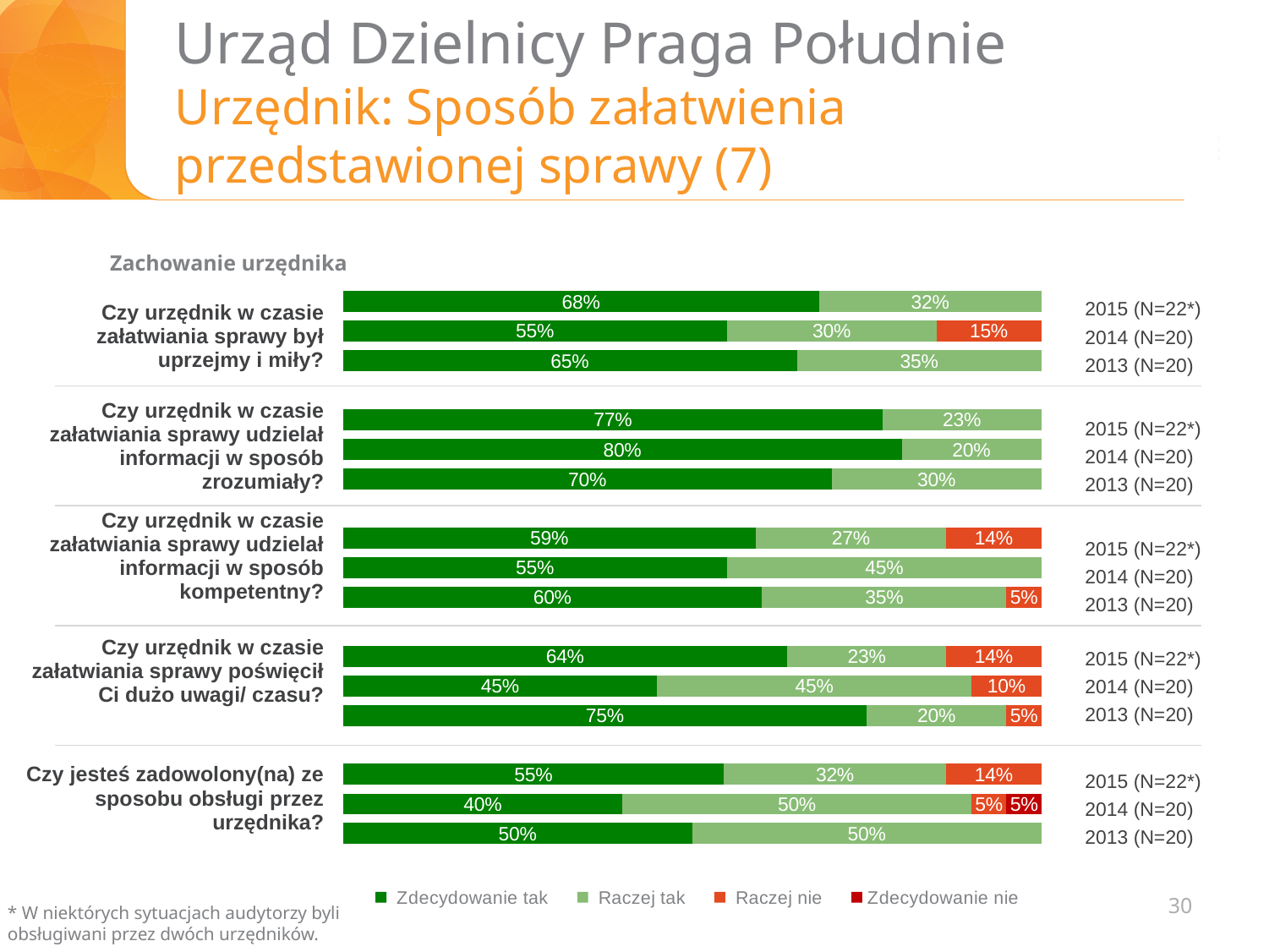
What percentage answered "Raczej nie" in 2014 to "Czy urzędnik w czasie załatwiania sprawy był uprzejmy i miły?"? 15% For "Czy urzędnik w czasie załatwiania sprawy był uprzejmy i miły?", by how many percentage points did the "Zdecydowanie tak" share in 2015 exceed that in 2014? 13 percentage points How many answer categories does the legend list? 4 How many survey questions are shown in the chart? 5 Among the 2015 bars, which question has the highest "Zdecydowanie tak" share? Czy urzędnik w czasie załatwiania sprawy udzielał informacji w sposób zrozumiały? What percentage answered "Zdecydowanie nie" in 2014 to "Czy jesteś zadowolony(na) ze sposobu obsługi przez urzędnika?"? 5% What was the "Zdecydowanie tak" share in 2014 for "Czy urzędnik w czasie załatwiania sprawy udzielał informacji w sposób zrozumiały?"? 80% For "Czy urzędnik w czasie załatwiania sprawy poświęcił Ci dużo uwagi/ czasu?", which year had the larger "Zdecydowanie tak" share, 2013 or 2014? 2013 Among the 2015 bars, which question has the lowest "Zdecydowanie tak" share? Czy jesteś zadowolony(na) ze sposobu obsługi przez urzędnika? What type of chart is shown on the slide? Stacked bar chart What is the total of the 2014 bar for "Czy jesteś zadowolony(na) ze sposobu obsługi przez urzędnika?"? 100% What percentage answered "Zdecydowanie tak" in 2015 to "Czy urzędnik w czasie załatwiania sprawy był uprzejmy i miły?"? 68%